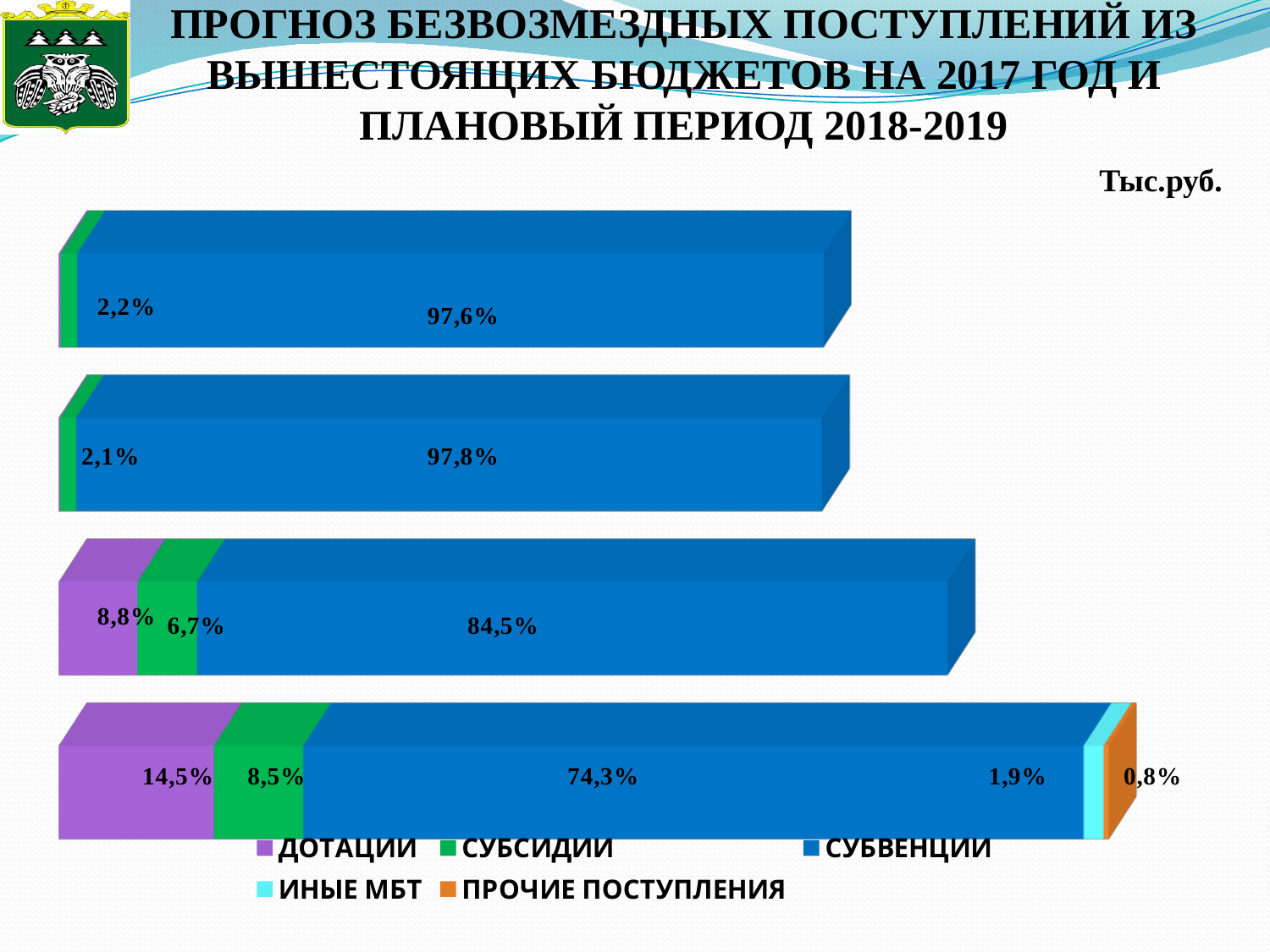
How many bars are plotted in the chart? 4 How many series does the legend list? 5 What is the difference between the share of СУБВЕНЦИИ in the third bar (84,5%) and in the bottom bar (74,3%)? 10,2% Which series has the largest share in the bottom bar? СУБВЕНЦИИ What kind of chart is shown on the slide? Stacked bar chart What is the share of ПРОЧИЕ ПОСТУПЛЕНИЯ in the bottom bar? 0,8% In the bottom bar, which is larger: the share of ДОТАЦИИ or the share of СУБСИДИИ? ДОТАЦИИ What is the share of ДОТАЦИИ in the third bar from the top? 8,8% What is the share of СУБСИДИИ in the second bar from the top? 2,1% What is the share of ИНЫЕ МБТ in the bottom bar? 1,9% What is the share of СУБВЕНЦИИ in the top bar? 97,6% Which series has the smallest share in the bottom bar? ПРОЧИЕ ПОСТУПЛЕНИЯ